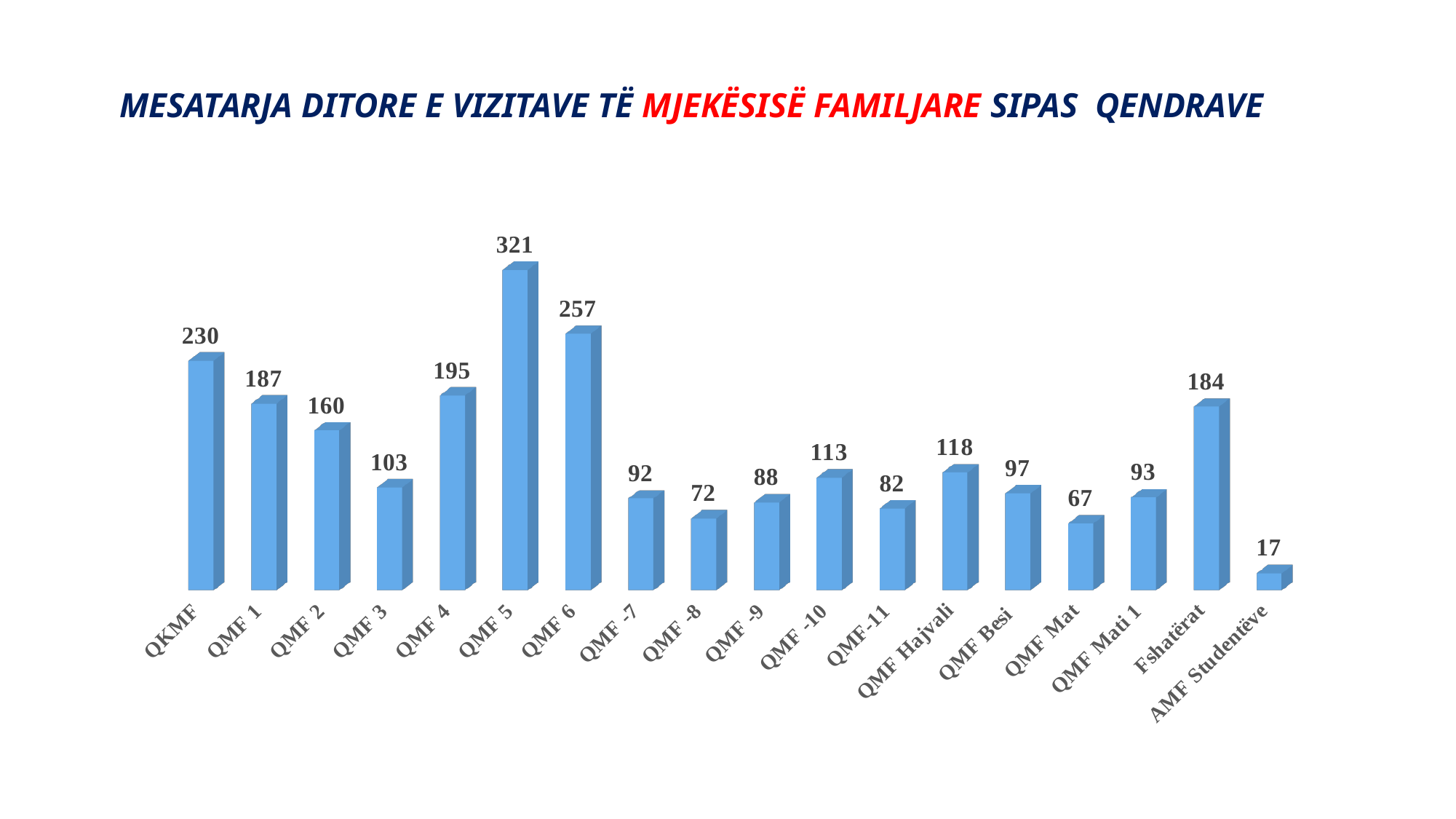
What is the value for Fshatërat? 184 What is the title of the chart? MESATARJA DITORE E VIZITAVE TË MJEKËSISË FAMILJARE SIPAS QENDRAVE How many categories are shown in the chart? 18 Which is larger, the value for QMF 4 or the value for QMF 2? QMF 4 Which is larger, the value for QMF Besi or the value for QMF Mat? QMF Besi What is the value for QMF Hajvali? 118 What is the difference between the values for QMF 5 and QMF 6? 64 Which category has the lowest value? AMF Studentëve Which category has the highest value? QMF 5 What is the value for QMF 5? 321 What kind of chart is shown on the slide? Bar chart What is the difference between the values for QKMF and QMF 1? 43